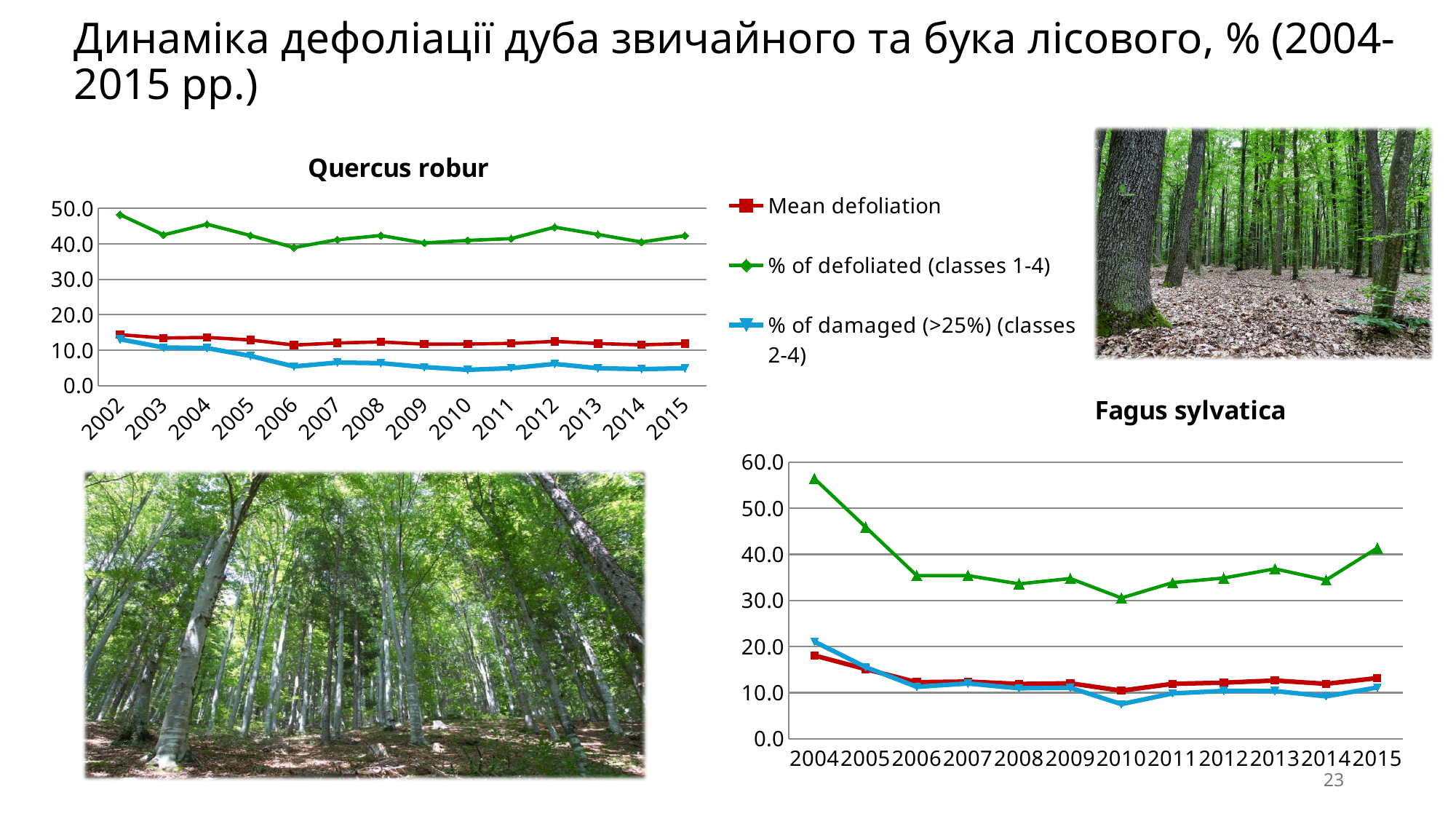
In the Fagus sylvatica chart, in which year is the % of defoliated (classes 1-4) highest? 2004 In the Quercus robur chart, is the % of damaged (>25%) (classes 2-4) in 2010 greater or less than 10.0? less In the Quercus robur chart, is the % of defoliated (classes 1-4) in 2002 greater or less than 40.0? greater In the Fagus sylvatica chart, is the % of defoliated (classes 1-4) in 2004 greater or less than 50.0? greater In the Quercus robur chart, how many years are plotted on the x axis? 14 What kind of chart is the Quercus robur chart? line chart In the Fagus sylvatica chart, does the % of defoliated (classes 1-4) rise or fall from 2004 to 2006? fall How many series does the legend list? 3 In the Fagus sylvatica chart, how many years are plotted on the x axis? 12 In the Fagus sylvatica chart, which is larger: the % of defoliated (classes 1-4) in 2004 or in 2015? 2004 In the Quercus robur chart, in which year is the % of defoliated (classes 1-4) lowest? 2006 In the Quercus robur chart, in which year is the % of defoliated (classes 1-4) highest? 2002